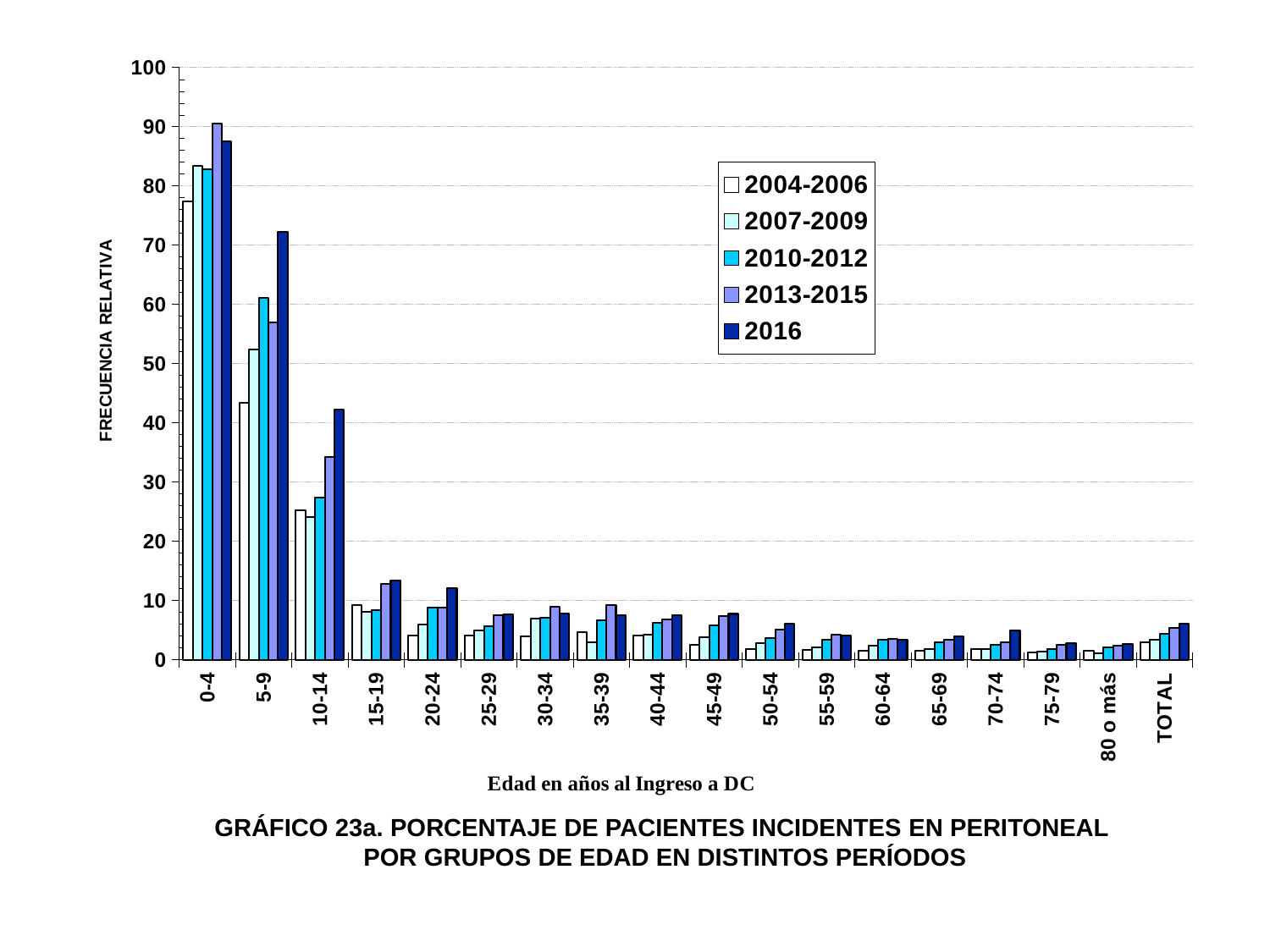
For the 2016 series, do the values generally rise or fall from the 0-4 group to the 80 o más group? fall Is the 2004-2006 value for the 0-4 age group greater or less than 80? less What is the title of the x axis? Edad en años al Ingreso a DC What kind of chart is shown on the slide? bar chart How many age-group categories (including TOTAL) are shown on the x axis? 18 For the 2016 series, which age group has the highest value? 0-4 Is the 2016 value for the 5-9 age group greater or less than 60? greater For the 0-4 age group, which is larger: the 2013-2015 value or the 2004-2006 value? 2013-2015 Is the 2013-2015 value for the 0-4 age group greater or less than 80? greater For the 5-9 age group, which is larger: the 2016 value or the 2004-2006 value? 2016 How many series does the legend list? 5